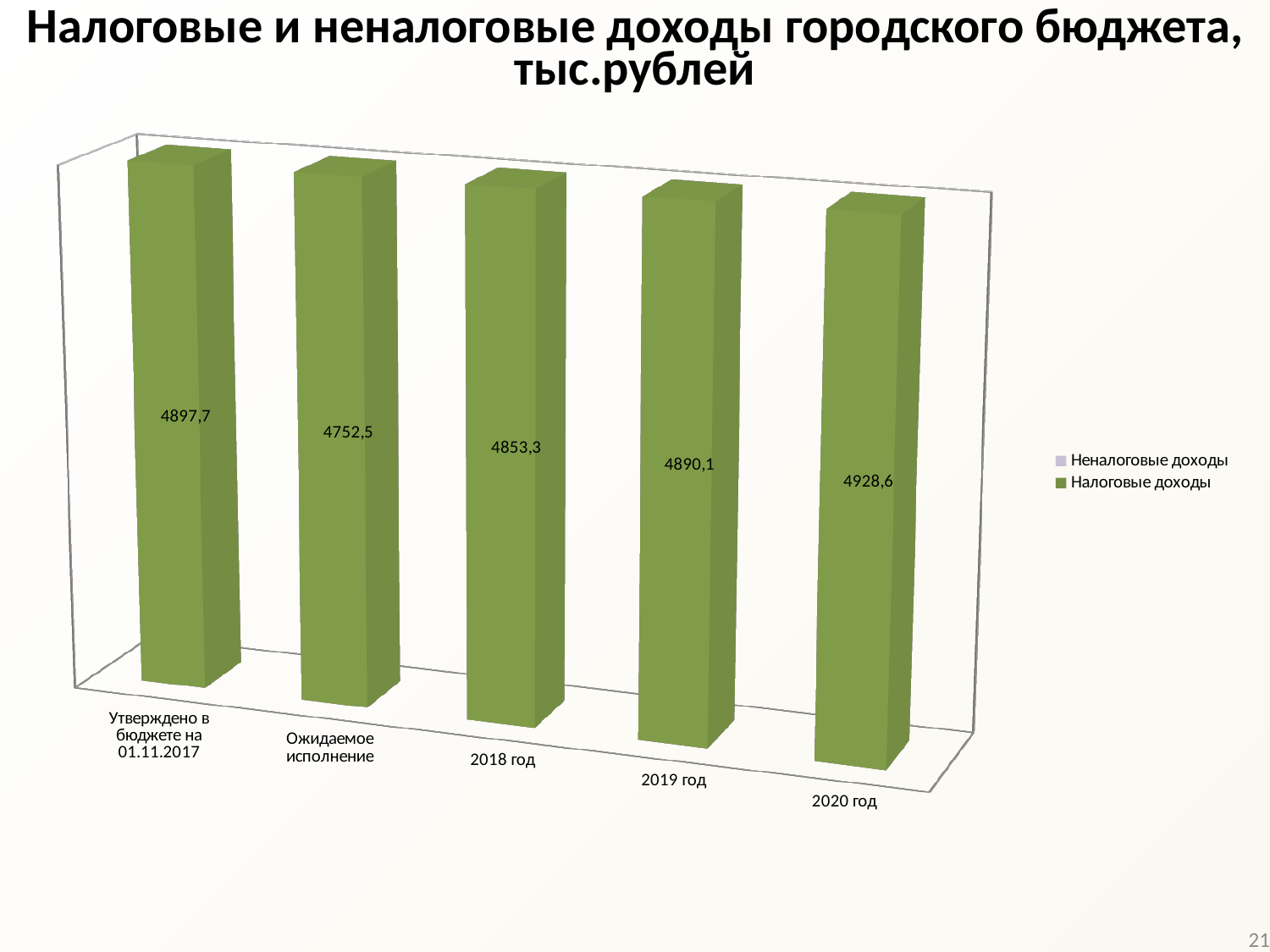
What is the difference between the Налоговые доходы values for 2019 год and 2018 год? 36,8 What is the difference between the Налоговые доходы values for 2020 год and Ожидаемое исполнение? 176,1 What is the value of Налоговые доходы for 2020 год? 4928,6 What is the value of Налоговые доходы for Утверждено в бюджете на 01.11.2017? 4897,7 How many series does the legend list? 2 Which category has the highest value of Налоговые доходы? 2020 год What is the value of Налоговые доходы for 2018 год? 4853,3 Which category has the lowest value of Налоговые доходы? Ожидаемое исполнение What is the value of Налоговые доходы for Ожидаемое исполнение? 4752,5 Which is larger, the Налоговые доходы value for 2019 год or for 2018 год? 2019 год How many categories are shown on the x axis of the chart? 5 Do the Налоговые доходы values rise or fall from 2018 год to 2020 год? rise